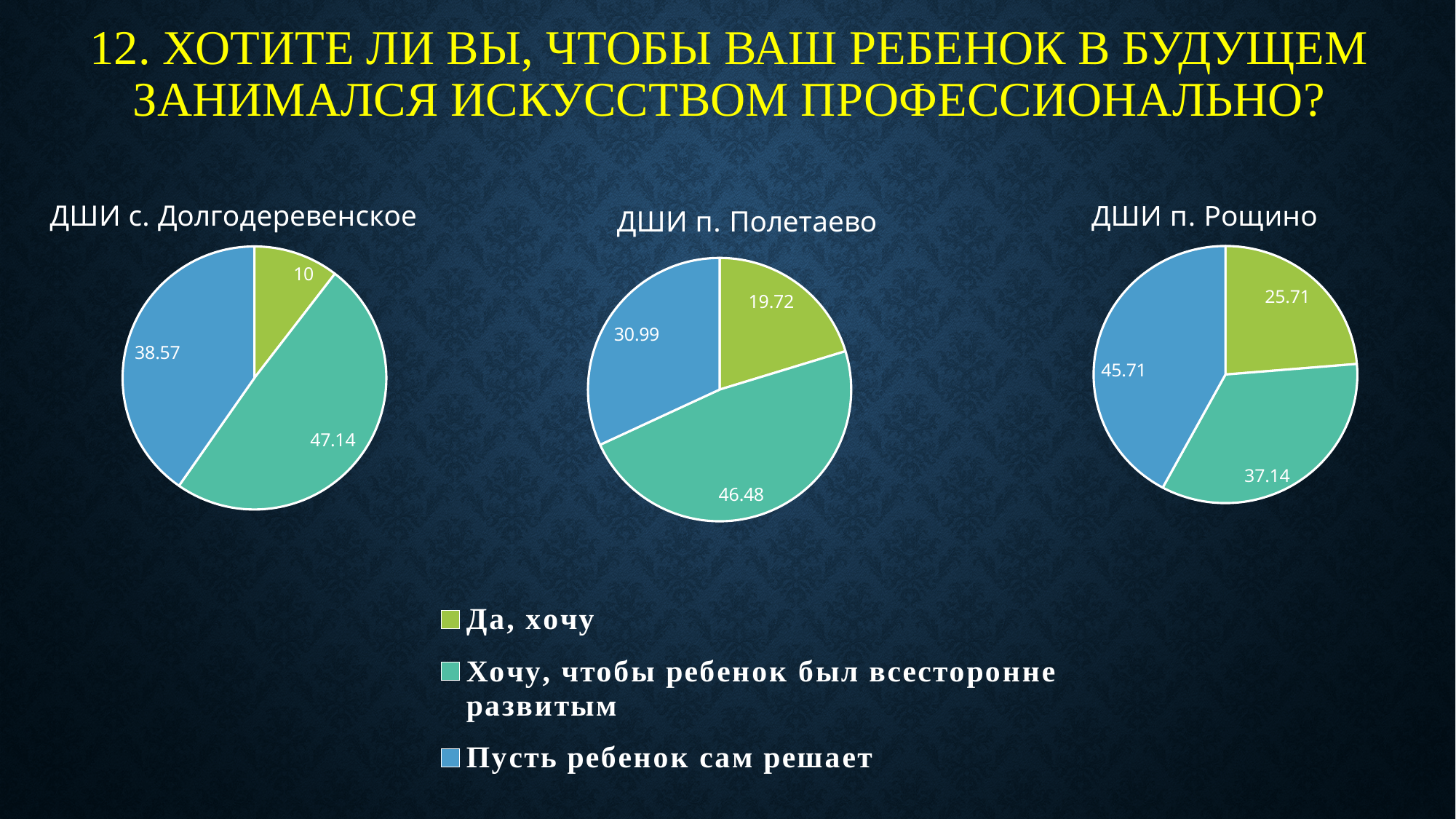
In the 'ДШИ с. Долгодеревенское' chart, which category has the largest slice? Хочу, чтобы ребенок был всесторонне развитым In the 'ДШИ с. Долгодеревенское' chart, what is the value for 'Да, хочу'? 10 In the 'ДШИ с. Долгодеревенское' chart, what is the difference between 'Хочу, чтобы ребенок был всесторонне развитым' and 'Пусть ребенок сам решает'? 8.57 What kind of chart is the 'ДШИ с. Долгодеревенское' chart? Pie chart In the 'ДШИ п. Полетаево' chart, what is the value for 'Пусть ребенок сам решает'? 30.99 How many entries does the legend list? 3 Which is larger in the 'ДШИ п. Полетаево' chart: 'Да, хочу' or 'Пусть ребенок сам решает'? Пусть ребенок сам решает In the 'ДШИ п. Рощино' chart, which category has the largest slice? Пусть ребенок сам решает How many slices does the 'ДШИ п. Рощино' chart have? 3 In the 'ДШИ п. Рощино' chart, what is the value for 'Хочу, чтобы ребенок был всесторонне развитым'? 37.14 In the 'ДШИ п. Рощино' chart, what is the difference between 'Пусть ребенок сам решает' and 'Да, хочу'? 20 In the 'ДШИ п. Полетаево' chart, which category has the smallest slice? Да, хочу